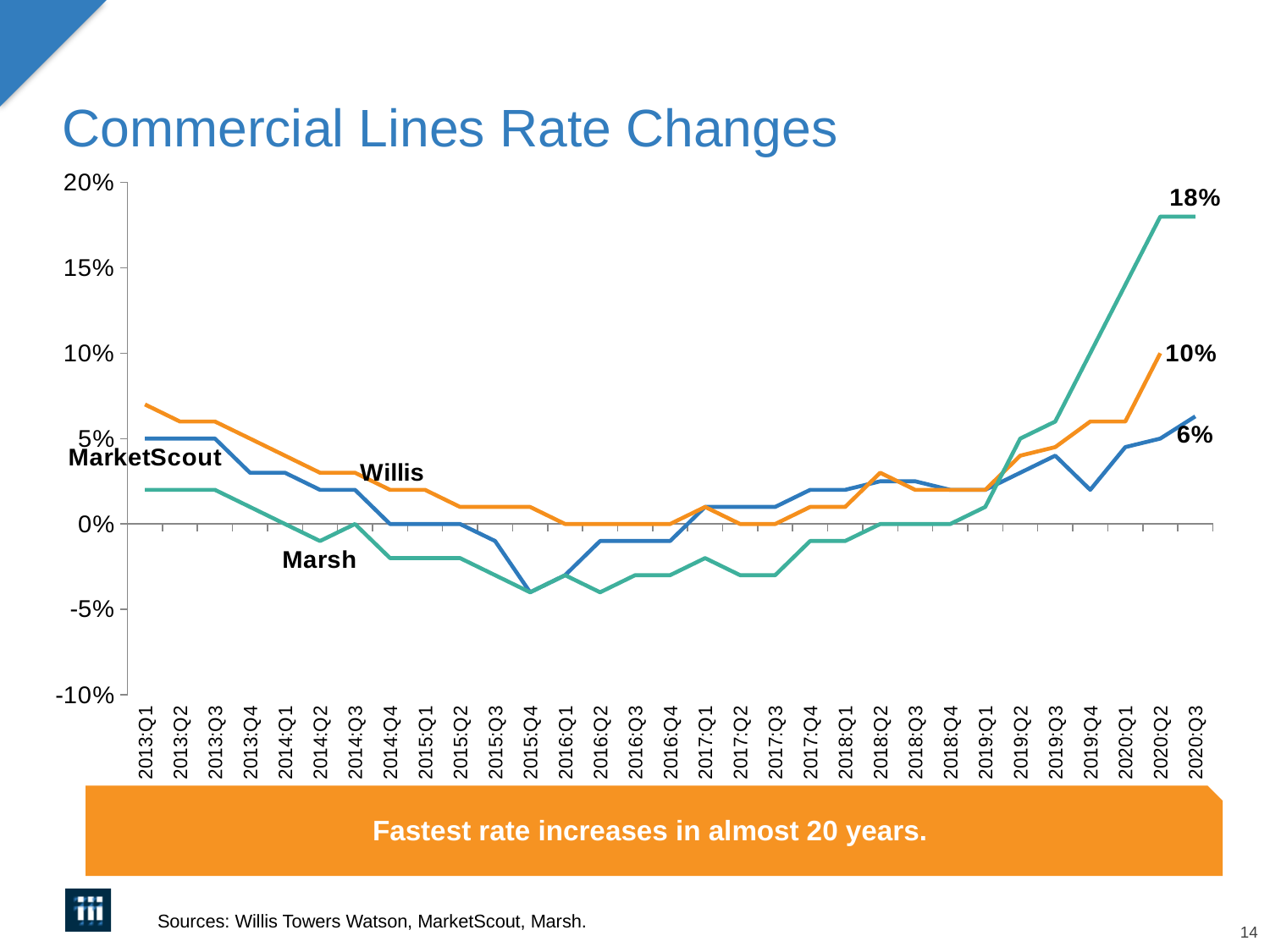
What kind of chart is shown on the slide? Line chart Does the Marsh series rise or fall between 2019:Q1 and 2020:Q2? Rises How many series are plotted on the chart? 3 What is the latest labelled value for the Marsh series? 18% Is the value for Marsh at 2015:Q4 greater or less than 0%? less What is the title of the chart? Commercial Lines Rate Changes Is the value for Willis at 2013:Q1 greater or less than 5%? greater What is the latest labelled value for the Willis series? 10% What is the difference between the labelled end values for Marsh (18%) and MarketScout (6%)? 12 percentage points What is the latest labelled value for the MarketScout series? 6% Which series has the lowest labelled value at the end of the chart? MarketScout Which series has the highest labelled value at the end of the chart? Marsh